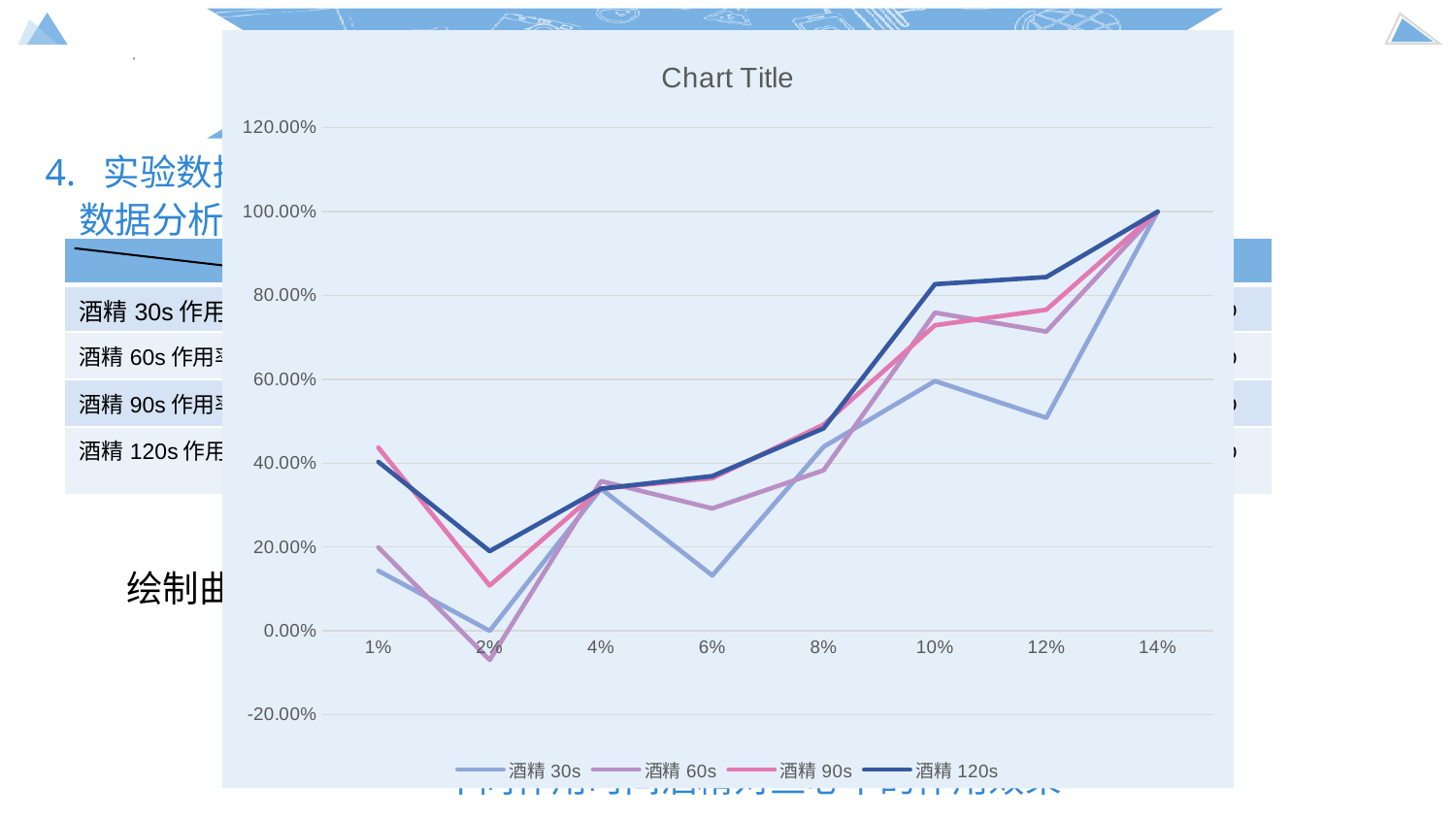
Is the value for 酒精 30s at 12% greater or less than 60.00%? less What is the title of the chart? Chart Title Is the value for 酒精 30s at 6% greater or less than 20.00%? less How many points are plotted along the x axis for each series? 8 How many series does the chart legend list? 4 What kind of chart is shown on the slide? line chart Which series has the lowest value at 2%? 酒精 60s At 6%, which is larger: the value for 酒精 120s or the value for 酒精 30s? 酒精 120s Is the value for 酒精 120s at 12% greater or less than 80.00%? greater Which series is drawn with the dark blue line in the chart? 酒精 120s Does the 酒精 120s line rise or fall from 6% to 14%? rise